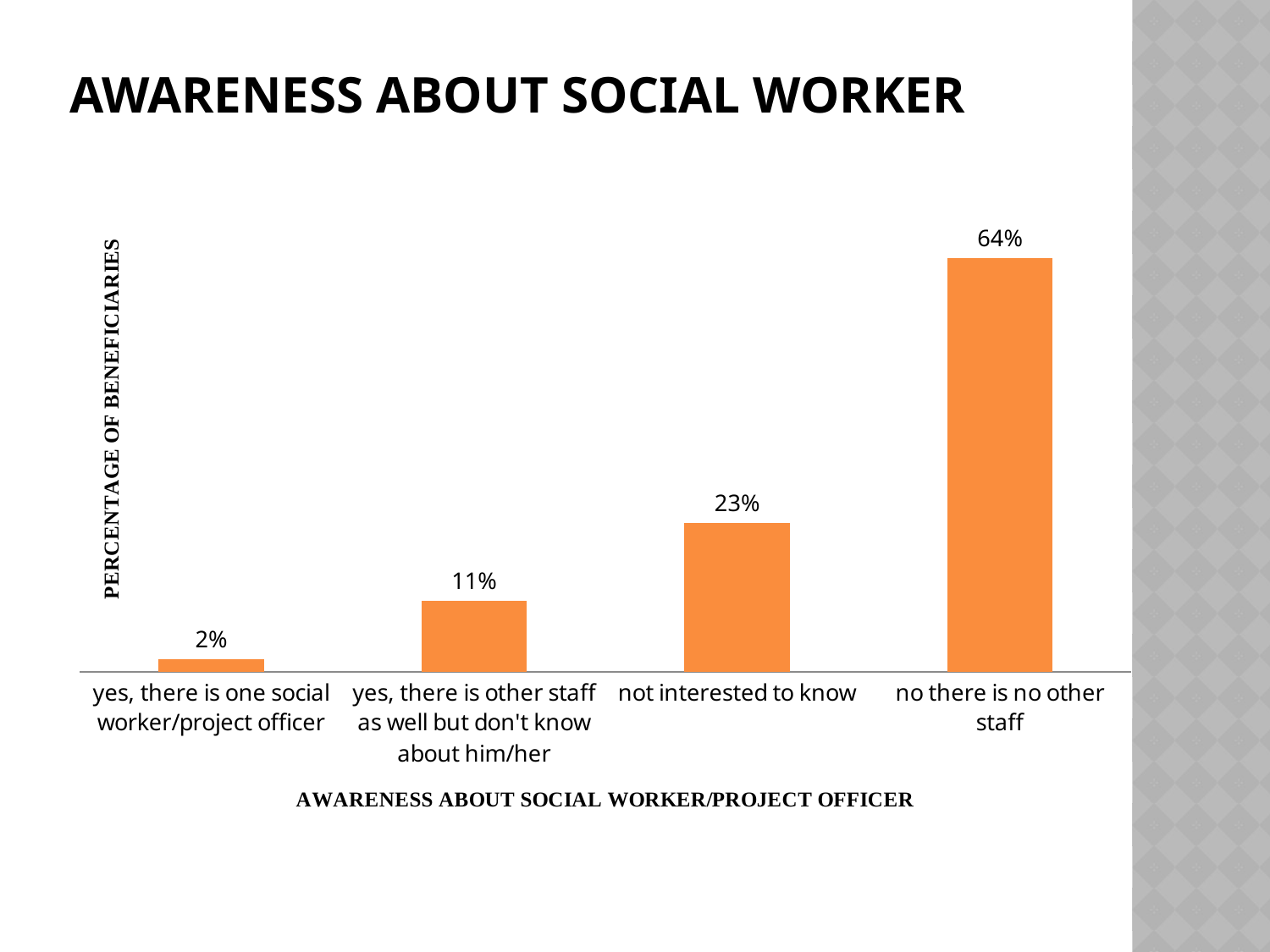
What is the label of the vertical axis? PERCENTAGE OF BENEFICIARIES Which category has the lowest percentage of beneficiaries? yes, there is one social worker/project officer What percentage of beneficiaries said there is no other staff? 64% What kind of chart is shown on the slide? bar chart Which category has the highest percentage of beneficiaries? no there is no other staff What percentage of beneficiaries said there is other staff as well but don't know about him/her? 11% How many categories are shown on the x axis? 4 What percentage of beneficiaries were not interested to know? 23% Which is larger: the percentage for 'not interested to know' or for 'yes, there is other staff as well but don't know about him/her'? not interested to know What percentage of beneficiaries said yes, there is one social worker/project officer? 2% What is the difference in percentage points between 'no there is no other staff' and 'not interested to know'? 41 What is the difference in percentage points between 'not interested to know' and 'yes, there is other staff as well but don't know about him/her'? 12